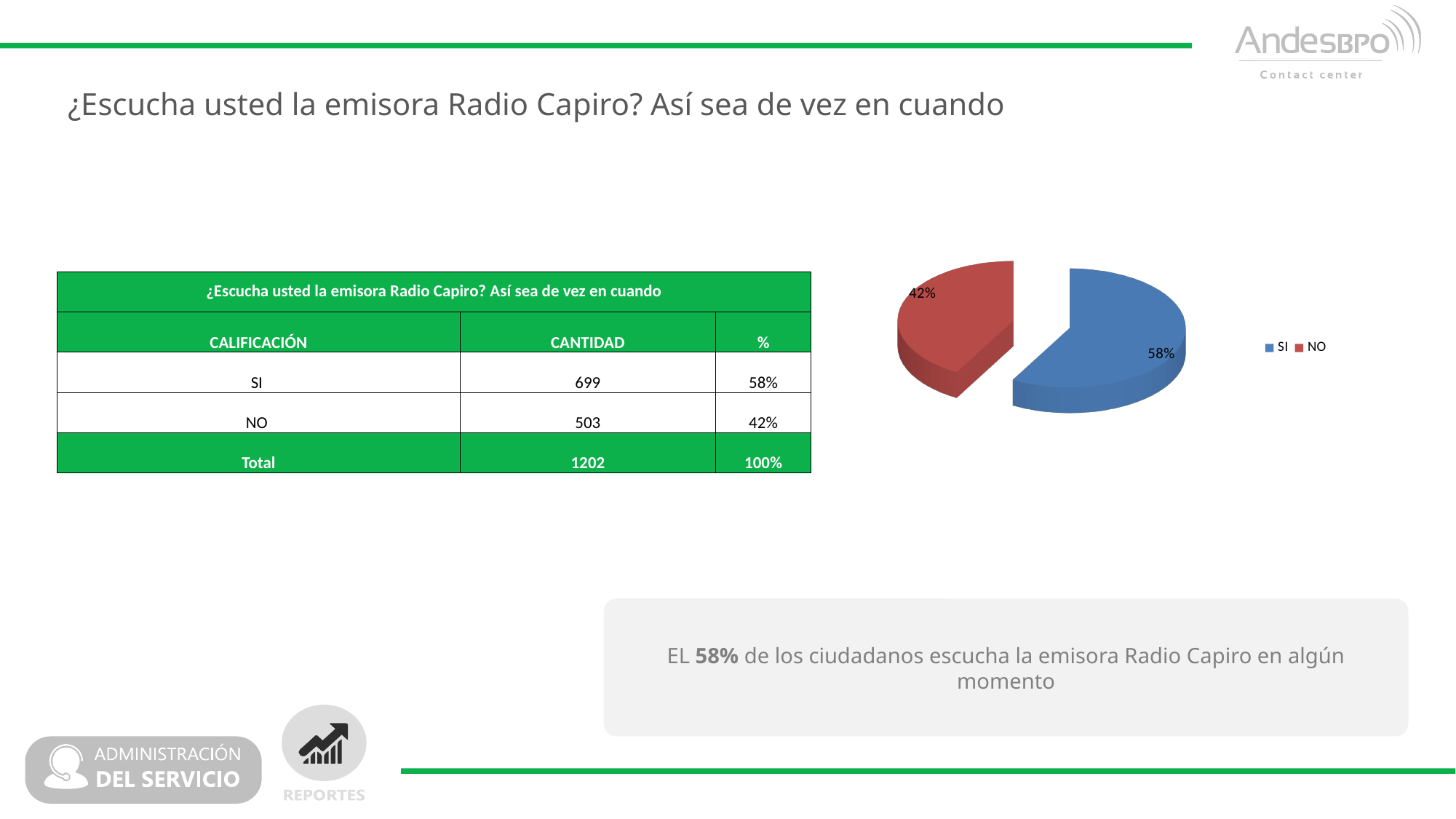
What is the difference in percentage points between the SI and NO slices? 16% What share of the pie does the SI slice represent? 58% Which is larger in the pie chart, SI or NO? SI What kind of chart is shown on the slide? pie chart How many entries does the legend of the pie chart list? 2 How many slices does the pie chart have? 2 Which slice of the pie chart is the largest? SI What colour is the SI slice in the pie chart? blue Which slice of the pie chart is the smallest? NO What colour is the NO slice in the pie chart? red What share of the pie does the NO slice represent? 42%